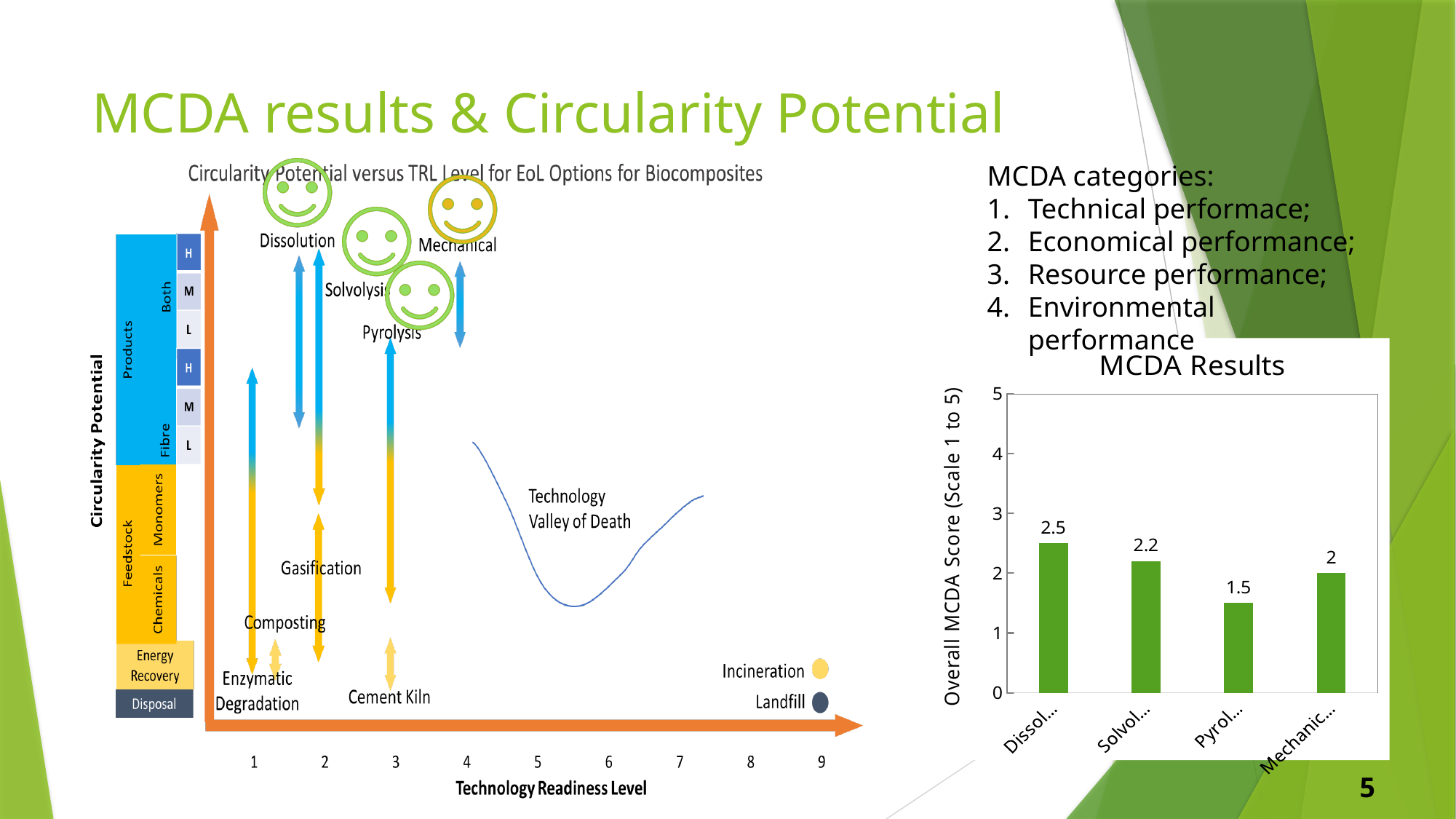
In the MCDA Results chart, what is the overall MCDA score for the last bar, labelled "Mechanic..."? 2 How many bars are plotted in the MCDA Results chart? 4 In the MCDA Results chart, which category has the lowest overall MCDA score? Pyrol... In the MCDA Results chart, what is the overall MCDA score for the bar labelled "Pyrol..."? 1.5 What kind of chart is the MCDA Results chart? bar chart In the MCDA Results chart, which has the larger score, "Solvol..." or "Mechanic..."? Solvol... In the MCDA Results chart, what is the difference between the scores for "Dissol..." and "Pyrol..."? 1 In the MCDA Results chart, is the score for "Pyrol..." greater or less than 2? less In the MCDA Results chart, what is the overall MCDA score for the bar labelled "Solvol..."? 2.2 In the MCDA Results chart, which category has the highest overall MCDA score? Dissol... What is the y-axis label of the MCDA Results chart? Overall MCDA Score (Scale 1 to 5) In the MCDA Results chart, what is the overall MCDA score for the first bar, labelled "Dissol..."? 2.5